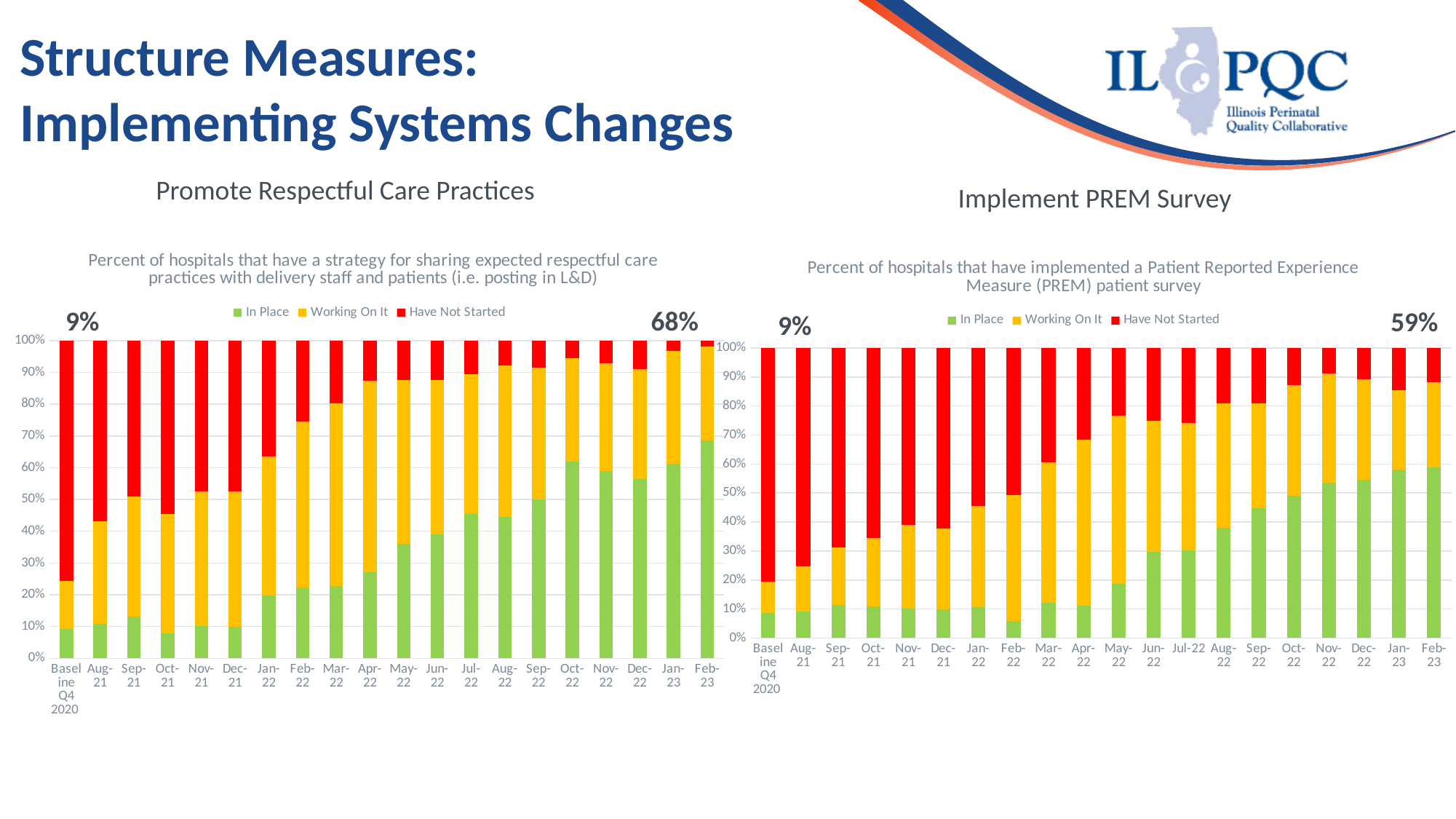
On the Promote Respectful Care Practices chart, what is the In Place value labelled for Feb-23? 68% On the Promote Respectful Care Practices chart, by how many percentage points did the In Place value rise from Baseline Q4 2020 to Feb-23? 59 percentage points On the Promote Respectful Care Practices chart, does the In Place share generally rise or fall from Baseline Q4 2020 to Feb-23? Rise On the Implement PREM Survey chart, what is the In Place value labelled for the Baseline Q4 2020 bar? 9% How many time periods are shown on the x axis of the Implement PREM Survey chart? 20 On the Promote Respectful Care Practices chart, what is the In Place value labelled for the Baseline Q4 2020 bar? 9% On the Implement PREM Survey chart, what is the In Place value labelled for Feb-23? 59% On the Implement PREM Survey chart, is the In Place value for Nov-22 greater or less than 50%? greater On the Implement PREM Survey chart, by how many percentage points did the In Place value rise from Baseline Q4 2020 to Feb-23? 50 percentage points How many series does the legend of the Promote Respectful Care Practices chart list? 3 On the Implement PREM Survey chart, which month has the lowest In Place value? Feb-22 What kind of chart is the Implement PREM Survey chart? Stacked bar chart